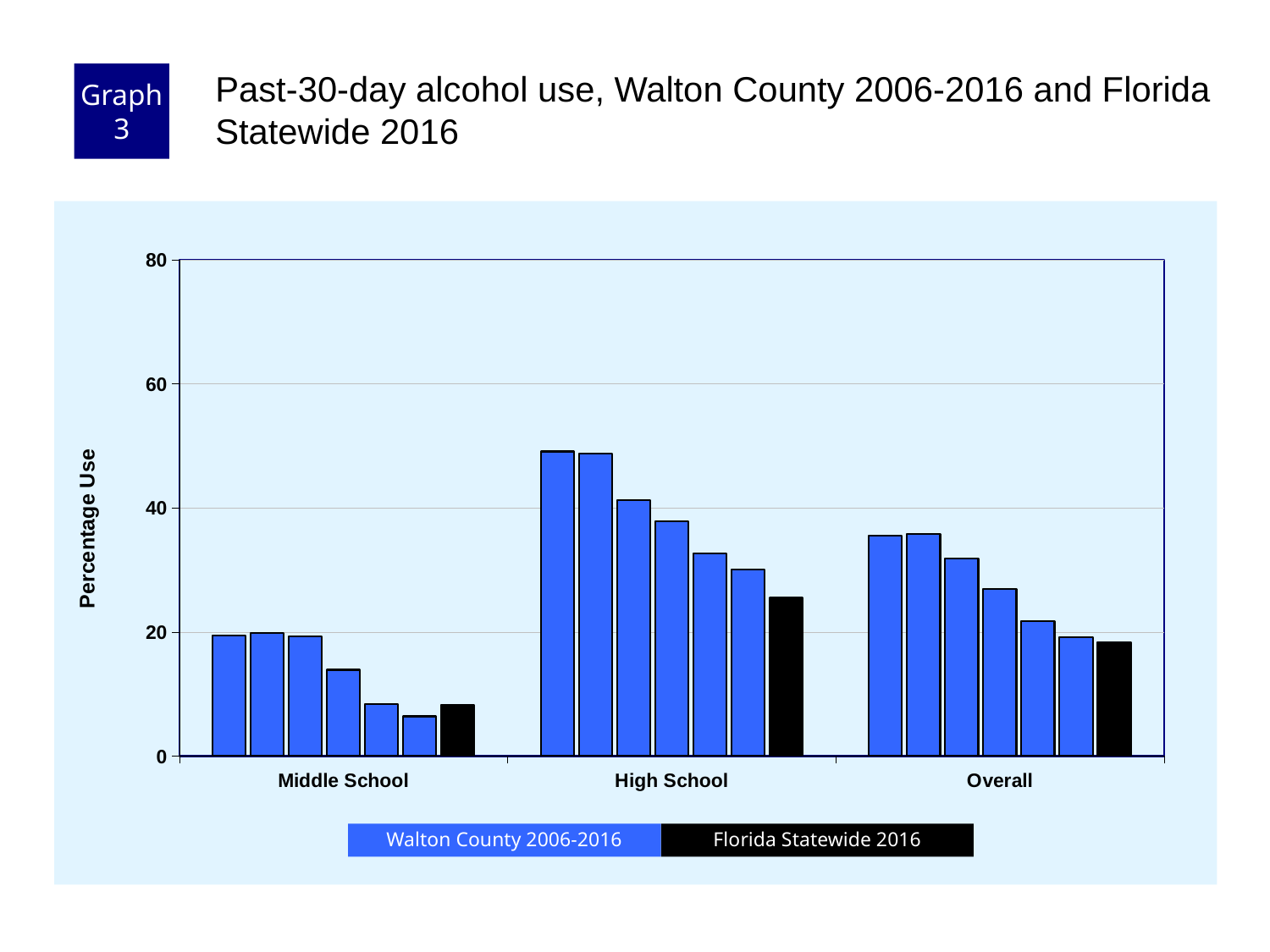
Which is larger: the Florida Statewide 2016 value for High School or for Overall? High School What is the label on the y axis? Percentage Use Within the High School group, do the Walton County 2006-2016 bars generally rise or fall from left to right? fall Is the tallest Walton County bar in the High School group greater or less than 40? greater Is the Florida Statewide 2016 value for Middle School greater or less than 20? less Is the Florida Statewide 2016 value for High School greater or less than 20? greater How many series does the legend list? 2 What kind of chart is shown on the slide? bar chart Which category has the lowest Florida Statewide 2016 value? Middle School How many school-level categories are shown on the x axis? 3 Which category has the highest Florida Statewide 2016 value? High School